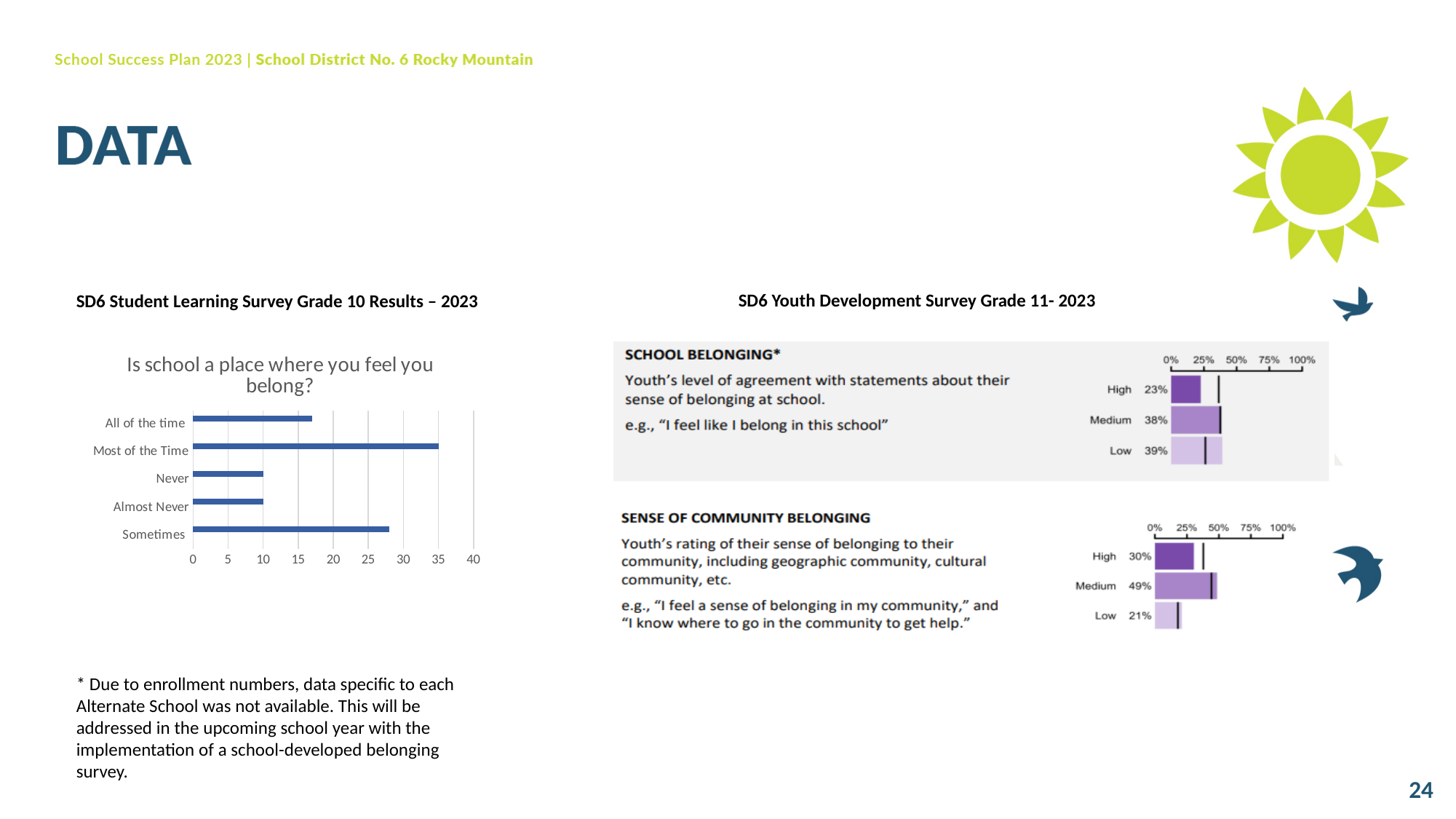
In the Sense of Community Belonging chart, which category has the highest value? Medium In the chart 'Is school a place where you feel you belong?', is the value for All of the time greater or less than 20? less In the School Belonging chart, what percentage of youth are in the Low category? 39% In the chart 'Is school a place where you feel you belong?', which category has the highest value? Most of the Time In the Sense of Community Belonging chart, which category has the lowest value? Low In the Sense of Community Belonging chart, what is the difference between the Medium and Low values? 28% What kind of chart is 'Is school a place where you feel you belong?' bar chart In the School Belonging chart, what is the difference between the Medium and High values? 15% How many categories are shown in the chart 'Is school a place where you feel you belong?' 5 In the chart 'Is school a place where you feel you belong?', is the value for Sometimes greater or less than 25? greater In the School Belonging chart, what percentage of youth are in the High category? 23% In the chart 'Is school a place where you feel you belong?', which is larger, Sometimes or All of the time? Sometimes